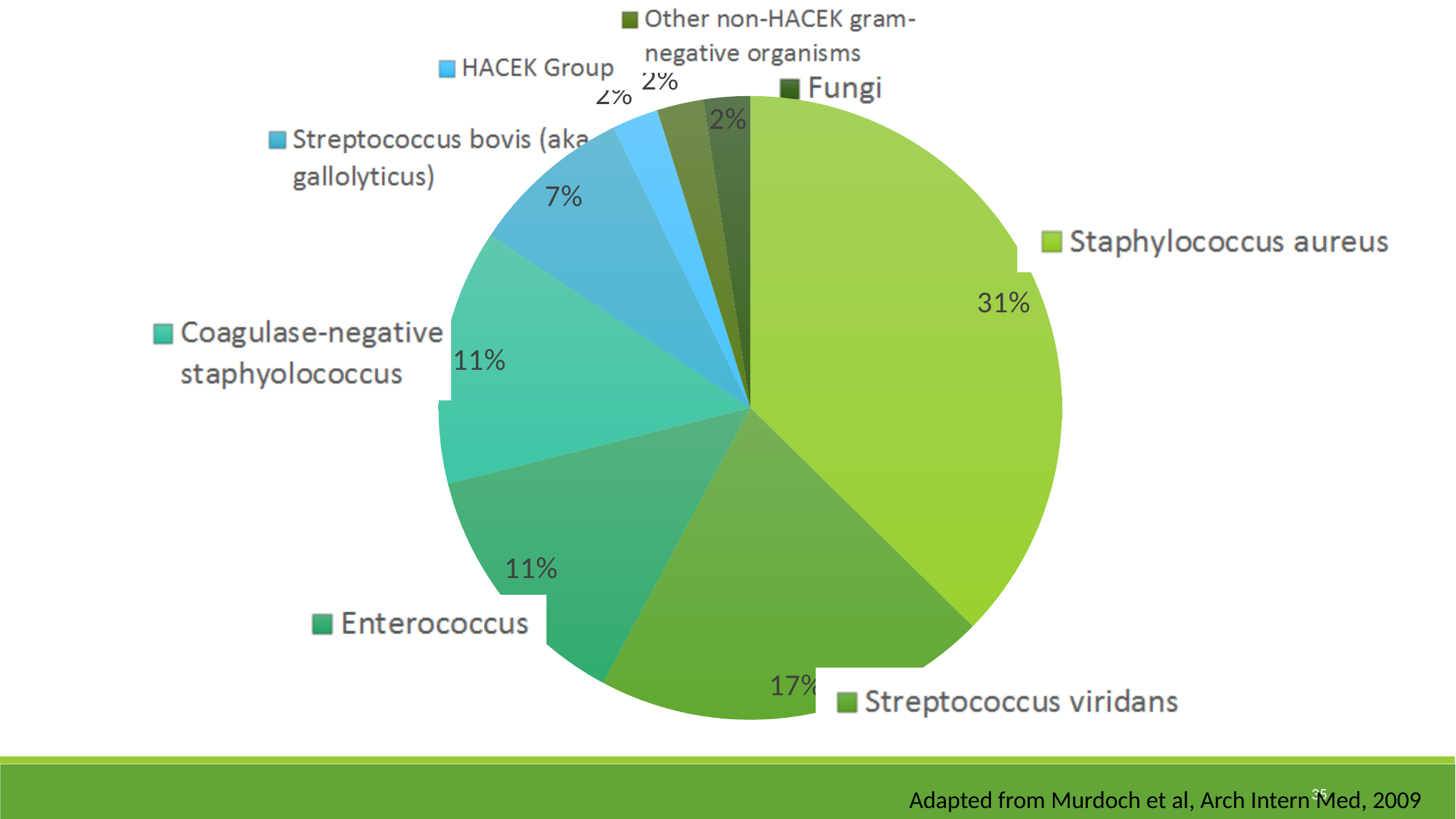
What percentage is shown for Enterococcus? 11% What percentage is shown for Coagulase-negative staphylococcus? 11% What percentage is shown for Streptococcus bovis (aka gallolyticus)? 7% According to the note at the bottom of the slide, what source is the chart adapted from? Murdoch et al, Arch Intern Med, 2009 How many categories (slices) does the pie chart have? 8 What kind of chart is shown on the slide? pie chart What percentage is shown for Streptococcus viridans? 17% Which slice is larger, Streptococcus viridans or Enterococcus? Streptococcus viridans What percentage is shown for Fungi? 2% How many percentage points larger is the Staphylococcus aureus slice than the Streptococcus viridans slice? 14 What percentage of the pie is Staphylococcus aureus? 31% Which organism has the largest slice of the pie? Staphylococcus aureus